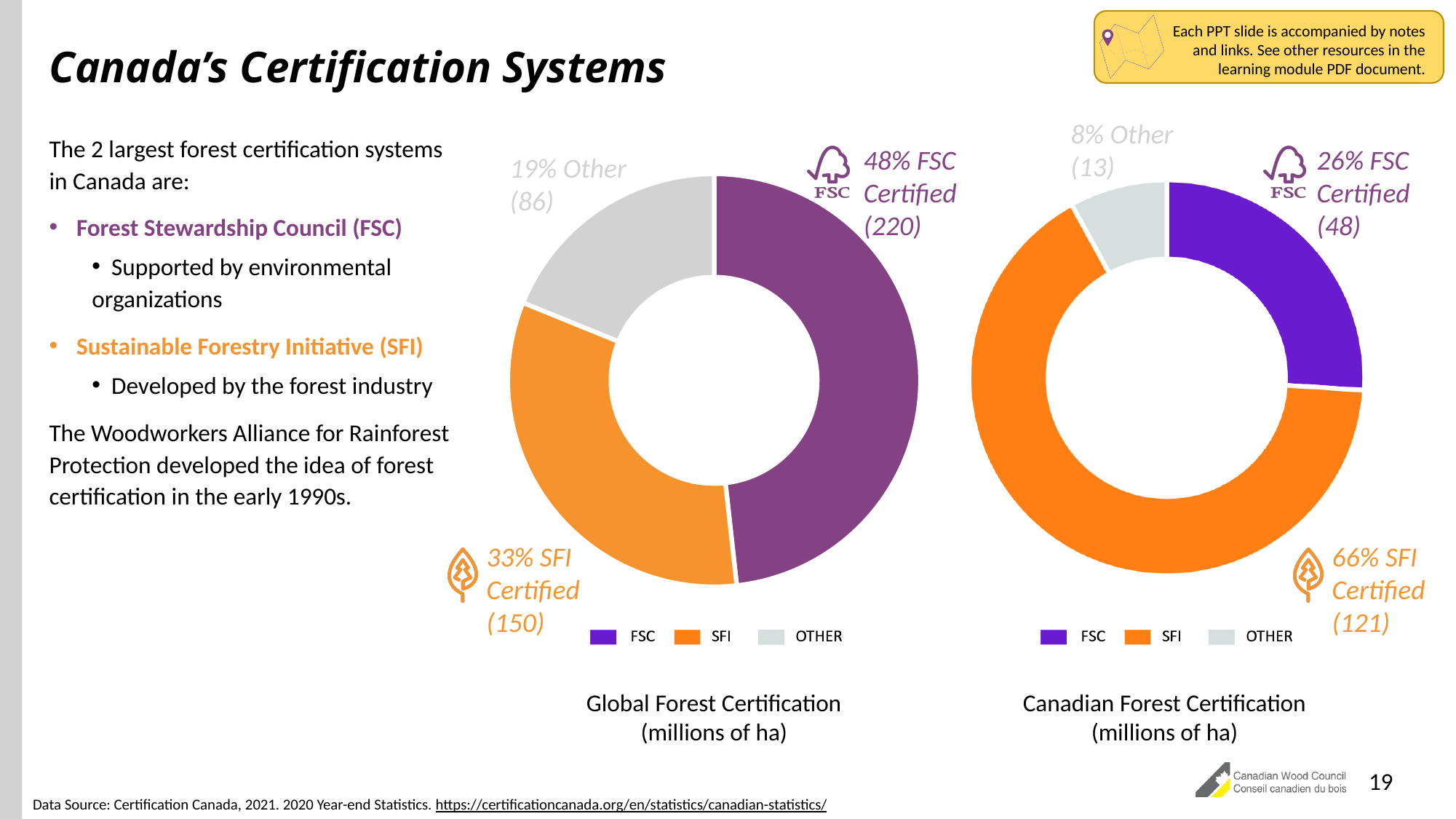
In the Global Forest Certification chart, what percentage is FSC Certified? 48% How many categories does the Global Forest Certification chart show? 3 In the Global Forest Certification chart, which category has the largest share? FSC In the Canadian Forest Certification chart, which category has the smallest share? Other In the Canadian Forest Certification chart, which is larger, the SFI Certified value or the FSC Certified value? SFI Certified In the Canadian Forest Certification chart, how many millions of ha are FSC Certified? 48 In the Global Forest Certification chart, what is the difference in millions of ha between FSC Certified and SFI Certified? 70 How many entries does the legend of the Canadian Forest Certification chart list? 3 What type of chart is the Canadian Forest Certification chart? Doughnut chart In the Canadian Forest Certification chart, what share of the total is Other? 8% In the Canadian Forest Certification chart, what percentage is SFI Certified? 66% In the Global Forest Certification chart, how many millions of ha are SFI Certified? 150